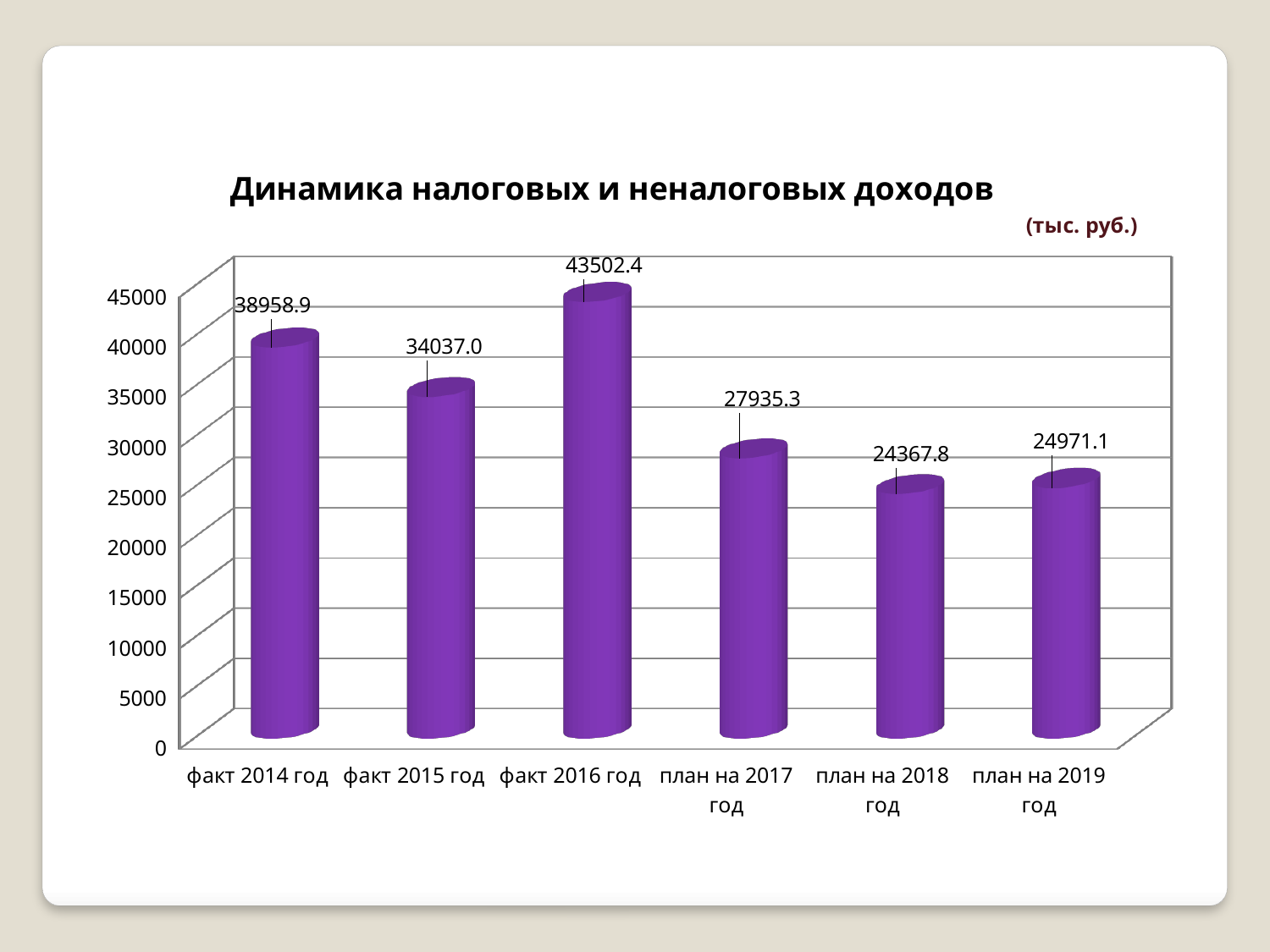
Which category has the highest value? факт 2016 год Which category has the lowest value? план на 2018 год Which is larger, the value for факт 2014 год or the value for факт 2015 год? факт 2014 год What kind of chart is shown on the slide? bar chart How many categories are shown on the x axis? 6 What is the value for план на 2018 год? 24367.8 What is the difference between the values for факт 2016 год and факт 2014 год? 4543.5 What unit is indicated for the values in the chart? тыс. руб. What is the value for факт 2015 год? 34037.0 What is the value for факт 2016 год? 43502.4 Is the value for план на 2017 год greater or less than 30000? less What is the difference between the values for план на 2019 год and план на 2018 год? 603.3